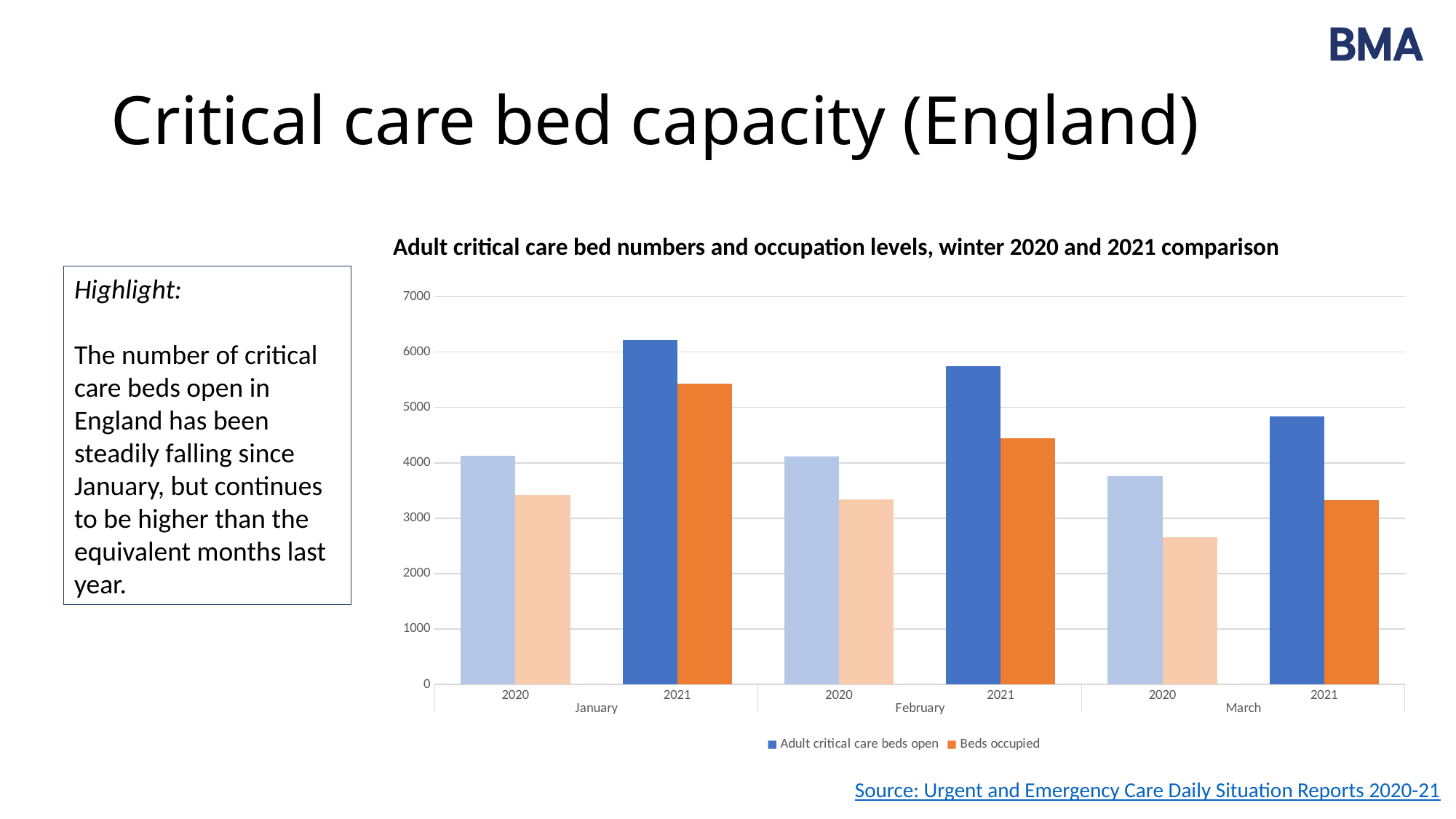
Is the value for beds occupied in February 2021 greater or less than 4000? greater Which month and year has the highest number of adult critical care beds open? January 2021 What kind of chart is shown on the slide? Bar chart Do the adult critical care beds open in 2021 rise or fall from January to March? Fall Which is larger: adult critical care beds open in January 2021 or in February 2021? January 2021 Is the value for beds occupied in March 2020 greater or less than 3000? less What is the title of the chart? Adult critical care bed numbers and occupation levels, winter 2020 and 2021 comparison What are the two series named in the chart legend? Adult critical care beds open; Beds occupied How many series does the chart legend list? 2 Which month and year has the lowest number of beds occupied? March 2020 How many months are compared along the x axis of the chart? 3 Is the value for adult critical care beds open in January 2021 greater or less than 6000? greater